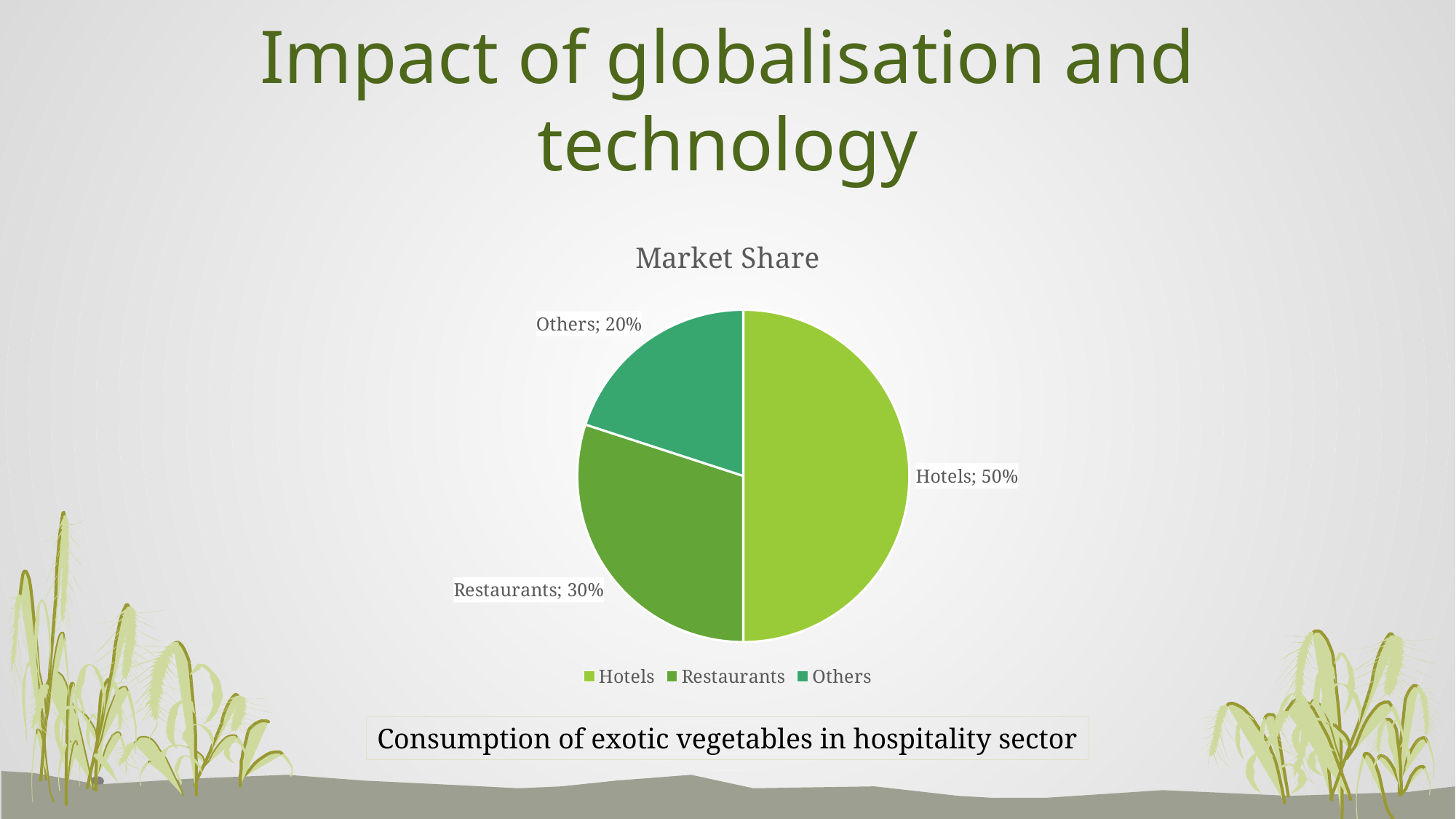
What is the difference in percentage points between the Hotels share and the Restaurants share? 20 How many slices does the pie chart have? 3 Which category has the largest share of the pie? Hotels What is the market share for Others? 20% What share of the pie does the Others slice represent? 20% Which is larger, the share for Restaurants or the share for Others? Restaurants What is the title of the chart? Market Share How many entries does the legend list? 3 What is the market share for Restaurants? 30% What is the market share for Hotels? 50% What type of chart is shown on the slide? pie chart Which category has the smallest share of the pie? Others